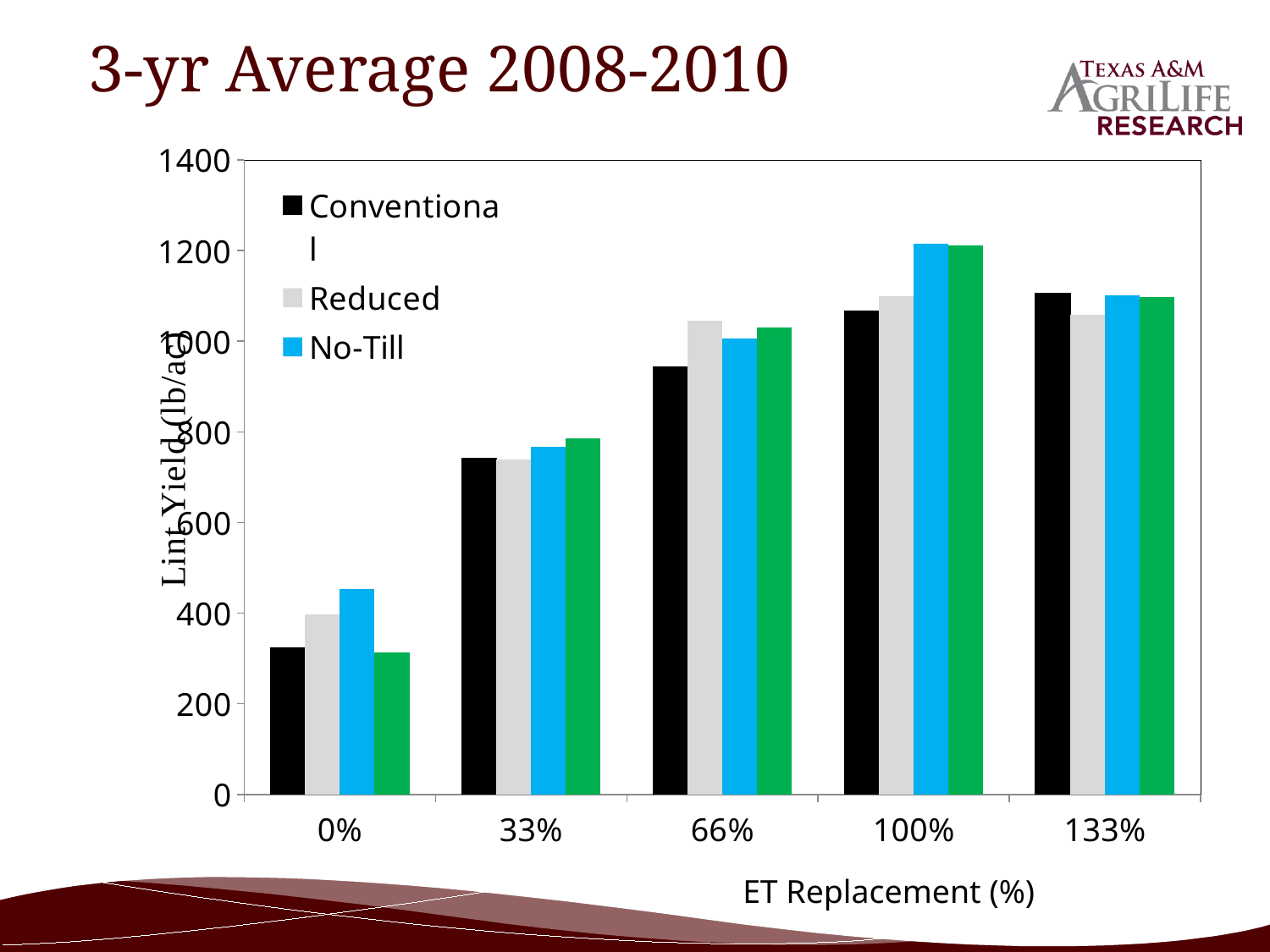
How many ET Replacement categories are shown on the x axis? 5 What is the title of the x axis? ET Replacement (%) Is the No-Till value at 0% ET Replacement greater or less than 400? greater Is the Conventional value at 66% ET Replacement greater or less than 1000? less How many series does the legend list? 3 At which ET Replacement level is the Conventional value lowest? 0% At which ET Replacement level is the No-Till value highest? 100% Is the Reduced value at 66% ET Replacement greater or less than 1000? greater Does the Conventional value rise or fall as ET Replacement increases from 0% to 133%? rise What kind of chart is shown on the slide? bar chart At 0% ET Replacement, which is larger: the Conventional value or the No-Till value? No-Till